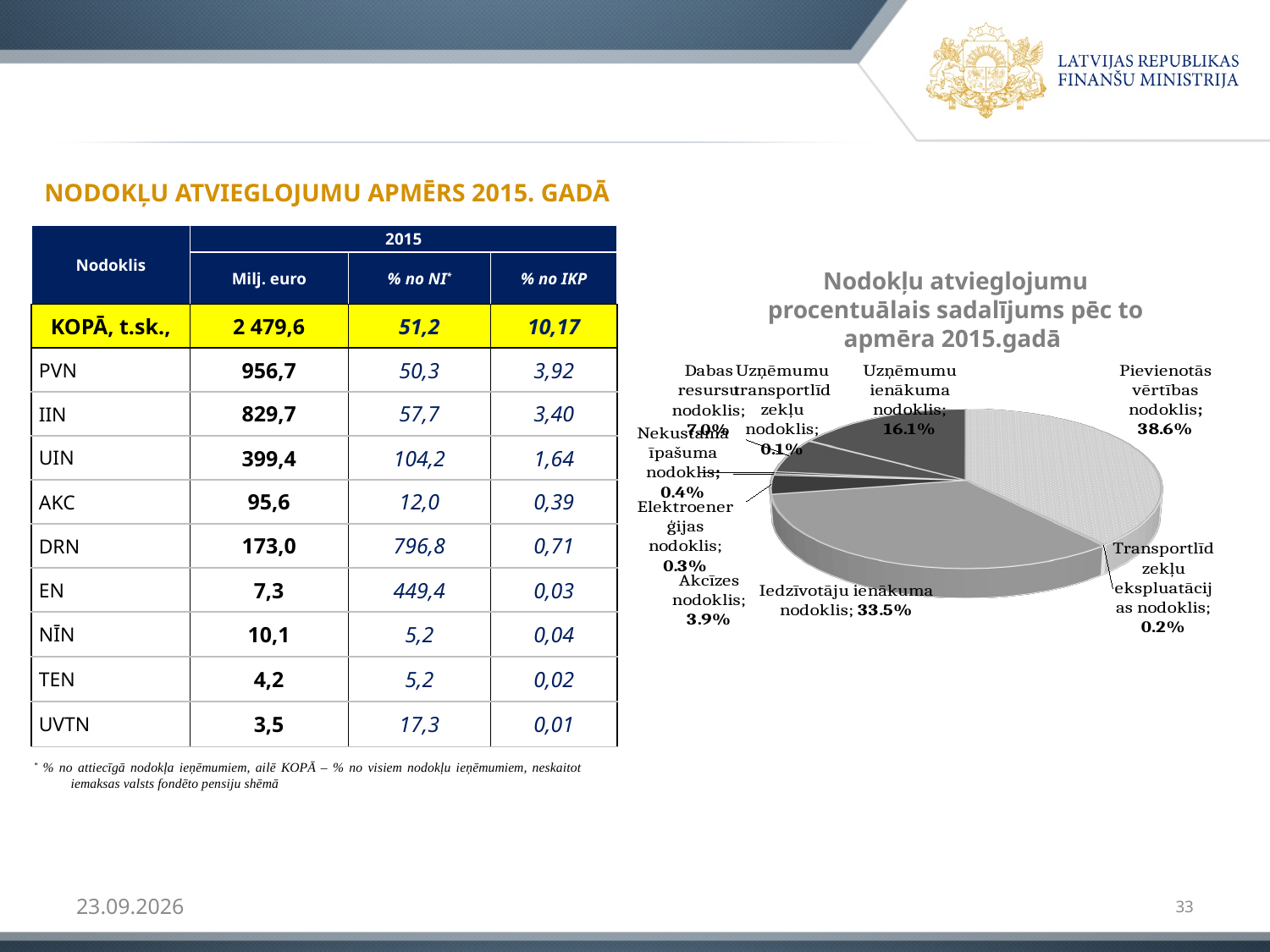
Which slice of the pie chart is the smallest? Uzņēmumu transportlīdzekļu nodoklis In the pie chart, what share is shown for Iedzīvotāju ienākuma nodoklis? 33.5% In the pie chart, what share is shown for Pievienotās vērtības nodoklis? 38.6% What kind of chart is shown on the slide? pie chart Which slice of the pie chart is the largest? Pievienotās vērtības nodoklis How many slices does the pie chart have? 9 In the pie chart, which is larger: Uzņēmumu ienākuma nodoklis or Dabas resursu nodoklis? Uzņēmumu ienākuma nodoklis What is the title of the pie chart? Nodokļu atvieglojumu procentuālais sadalījums pēc to apmēra 2015.gadā In the pie chart, what share is shown for Akcīzes nodoklis? 3.9% In the pie chart, what share is shown for Dabas resursu nodoklis? 7.0% In the pie chart, what is the difference in percentage points between Pievienotās vērtības nodoklis and Iedzīvotāju ienākuma nodoklis? 5.1 In the pie chart, what share is shown for Uzņēmumu ienākuma nodoklis? 16.1%